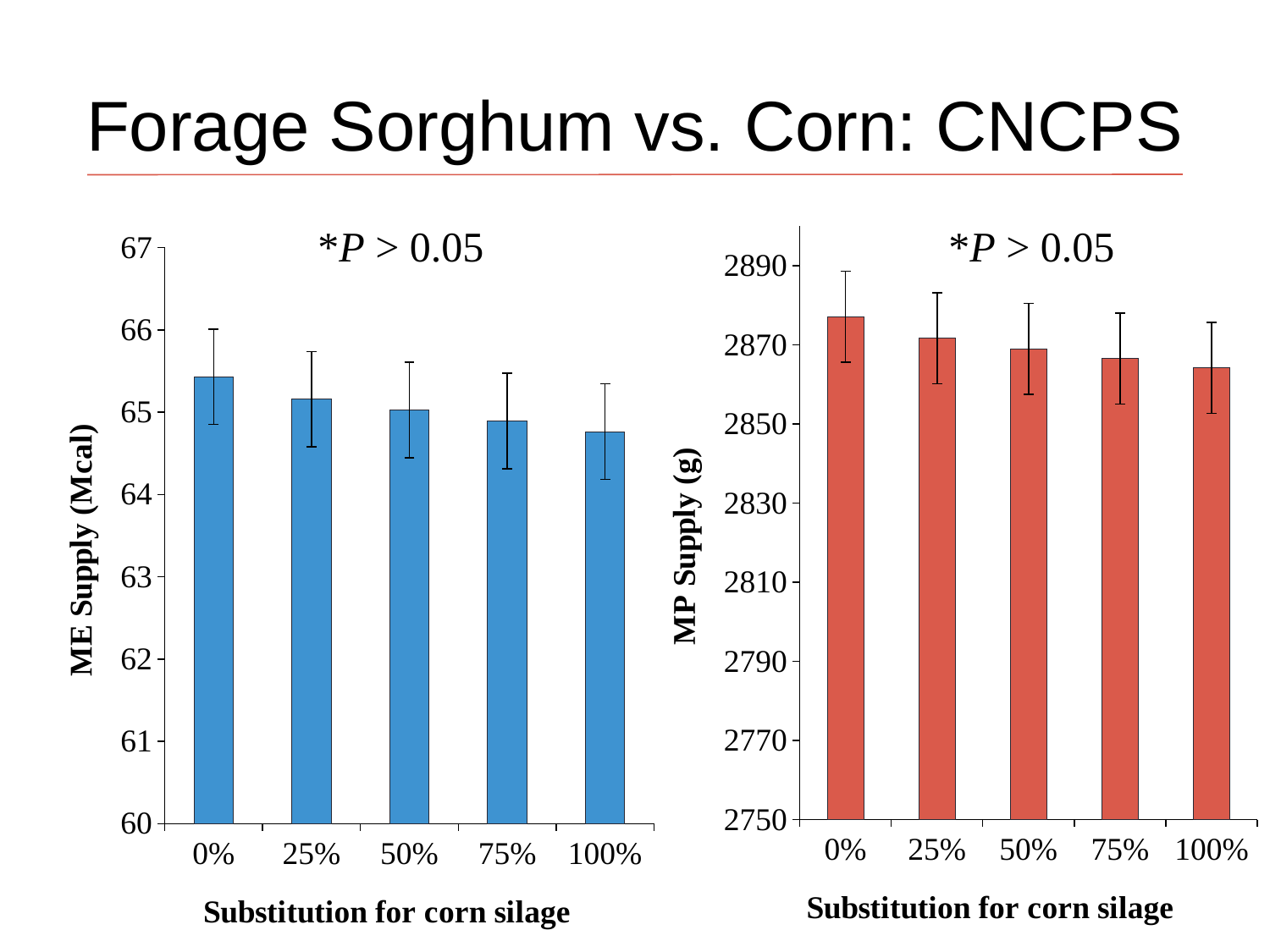
In the right chart (MP Supply), do the values rise or fall as the substitution level increases from 0% to 100%? fall In the right chart (MP Supply), is the value for 100% greater or less than 2870? less In the left chart (ME Supply), is the value for 100% greater or less than 65? less What kind of chart is the left chart (ME Supply)? bar chart In the left chart (ME Supply), is the value for 0% greater or less than 65? greater In the left chart (ME Supply), which substitution level has the highest ME supply? 0% What is the y-axis label of the right chart? MP Supply (g) How many substitution levels are shown on the x axis of the right chart (MP Supply)? 5 In the right chart (MP Supply), which substitution level has the highest MP supply? 0% In the left chart (ME Supply), which substitution level has the lowest ME supply? 100% In the left chart (ME Supply), which is larger, the value for 0% or the value for 100%? 0%